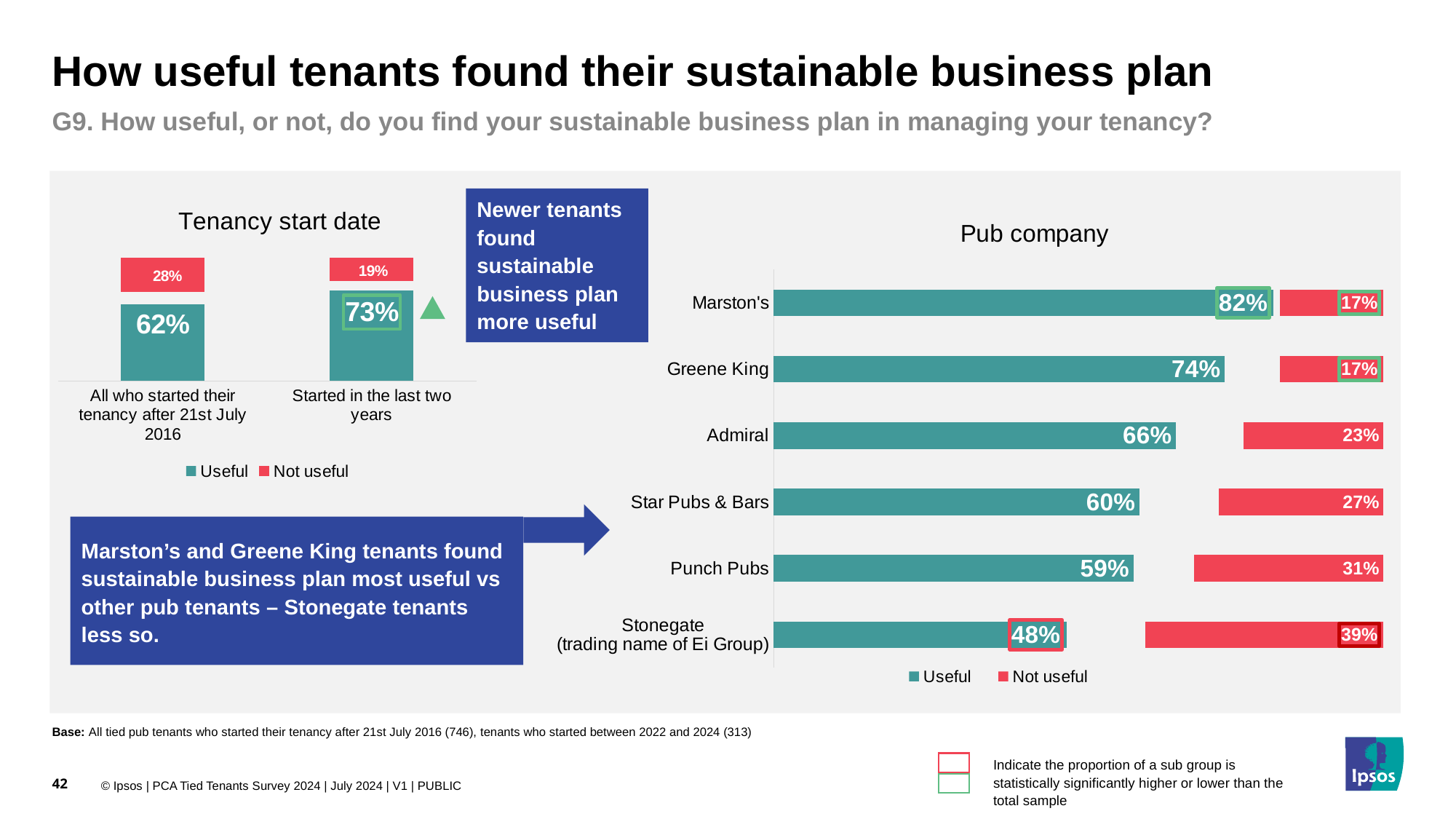
In the 'Pub company' chart, which pub company has the highest 'Useful' value? Marston's What type of chart is the 'Pub company' chart? Bar chart How many pub companies are shown in the 'Pub company' chart? 6 In the 'Pub company' chart, what percentage of Marston's tenants found the sustainable business plan useful? 82% In the 'Pub company' chart, which has a larger 'Not useful' value, Punch Pubs or Admiral? Punch Pubs In the 'Tenancy start date' chart, what is the 'Useful' value for those who started in the last two years? 73% In the 'Pub company' chart, what is the 'Not useful' value for Stonegate (trading name of Ei Group)? 39% In the 'Pub company' chart, which pub company has the lowest 'Useful' value? Stonegate (trading name of Ei Group) In the 'Pub company' chart, what is the difference between the 'Useful' values for Marston's and Greene King? 8 percentage points How many series does the legend of the 'Pub company' chart list? 2 In the 'Tenancy start date' chart, what is the 'Not useful' value for all who started their tenancy after 21st July 2016? 28% In the 'Tenancy start date' chart, what is the difference between the 'Useful' values for the two groups? 11 percentage points